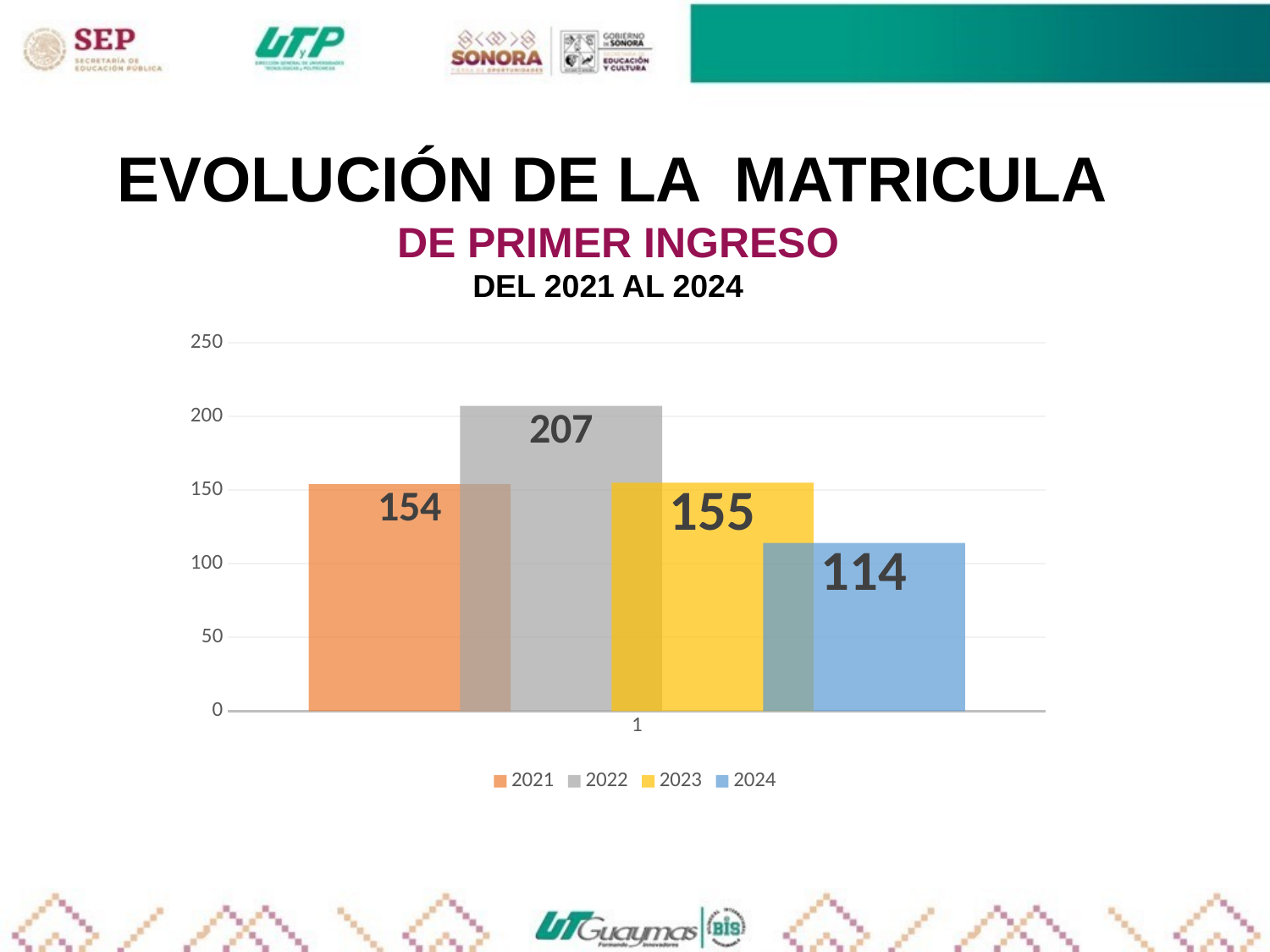
What is the value for 2021? 154 Which year has the lowest value? 2024 What is the difference between the values for 2023 and 2021? 1 What is the difference between the values for 2022 and 2024? 93 Which is larger, the value for 2022 or the value for 2023? 2022 What kind of chart is shown on the slide? bar chart Which year has the highest value? 2022 How many series does the legend list? 4 What colour is the bar for 2023? yellow What is the value for 2022? 207 What is the value for 2024? 114 Is the value for 2022 greater or less than 200? greater